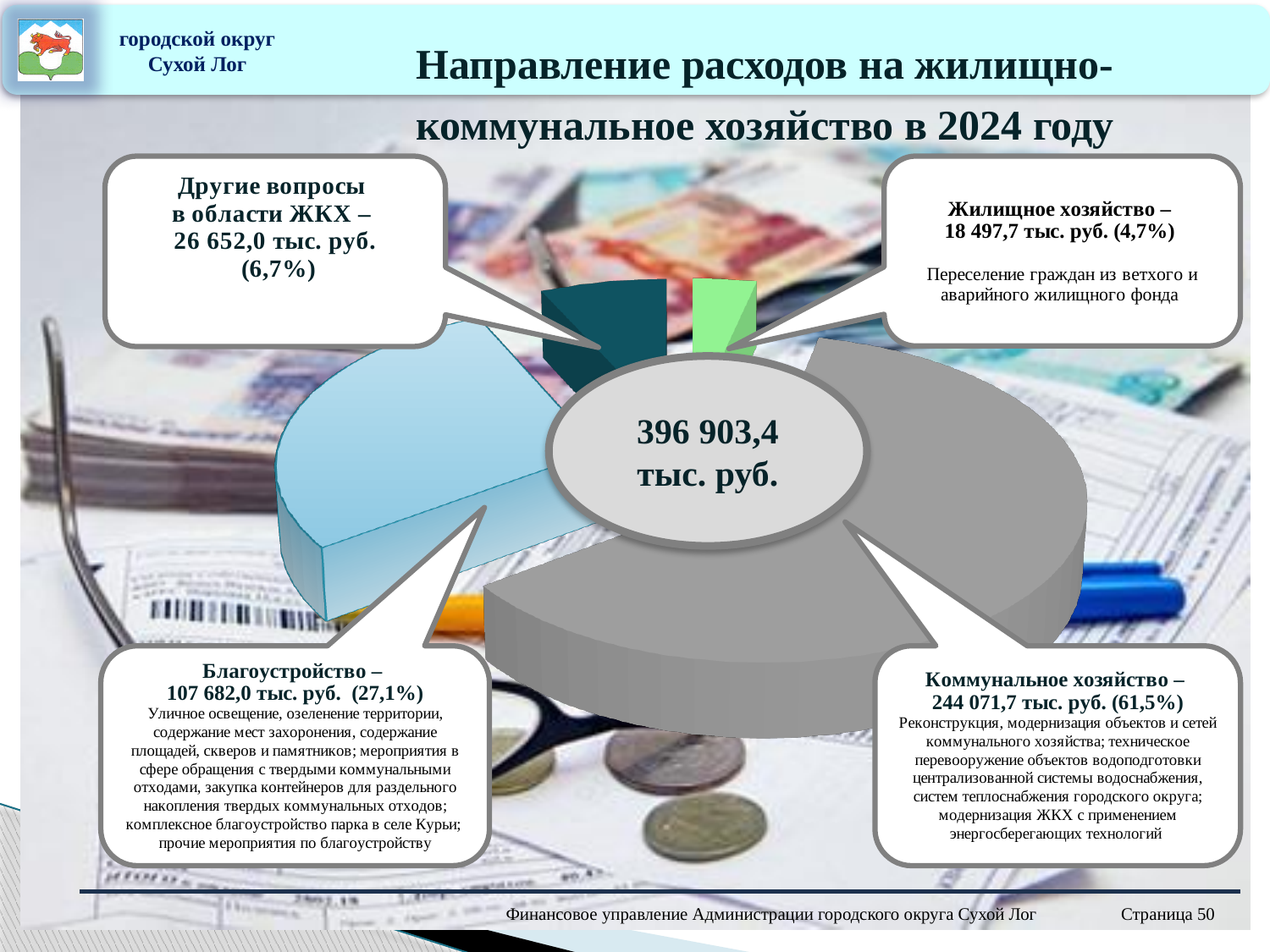
What is the value for Благоустройство? 107 682,0 тыс. руб. What kind of chart is shown on the slide? pie chart What total is shown in the centre of the pie chart? 396 903,4 тыс. руб. Which category has the largest slice? Коммунальное хозяйство Which is larger, Благоустройство or Другие вопросы в области ЖКХ? Благоустройство What share of the pie does Другие вопросы в области ЖКХ take? 6,7% How many slices does the pie chart have? 4 What is the value for Коммунальное хозяйство? 244 071,7 тыс. руб. What is the value for Жилищное хозяйство? 18 497,7 тыс. руб. Which category has the smallest slice? Жилищное хозяйство What is the difference between Коммунальное хозяйство and Благоустройство? 136 389,7 тыс. руб. What share of the pie does Коммунальное хозяйство take? 61,5%